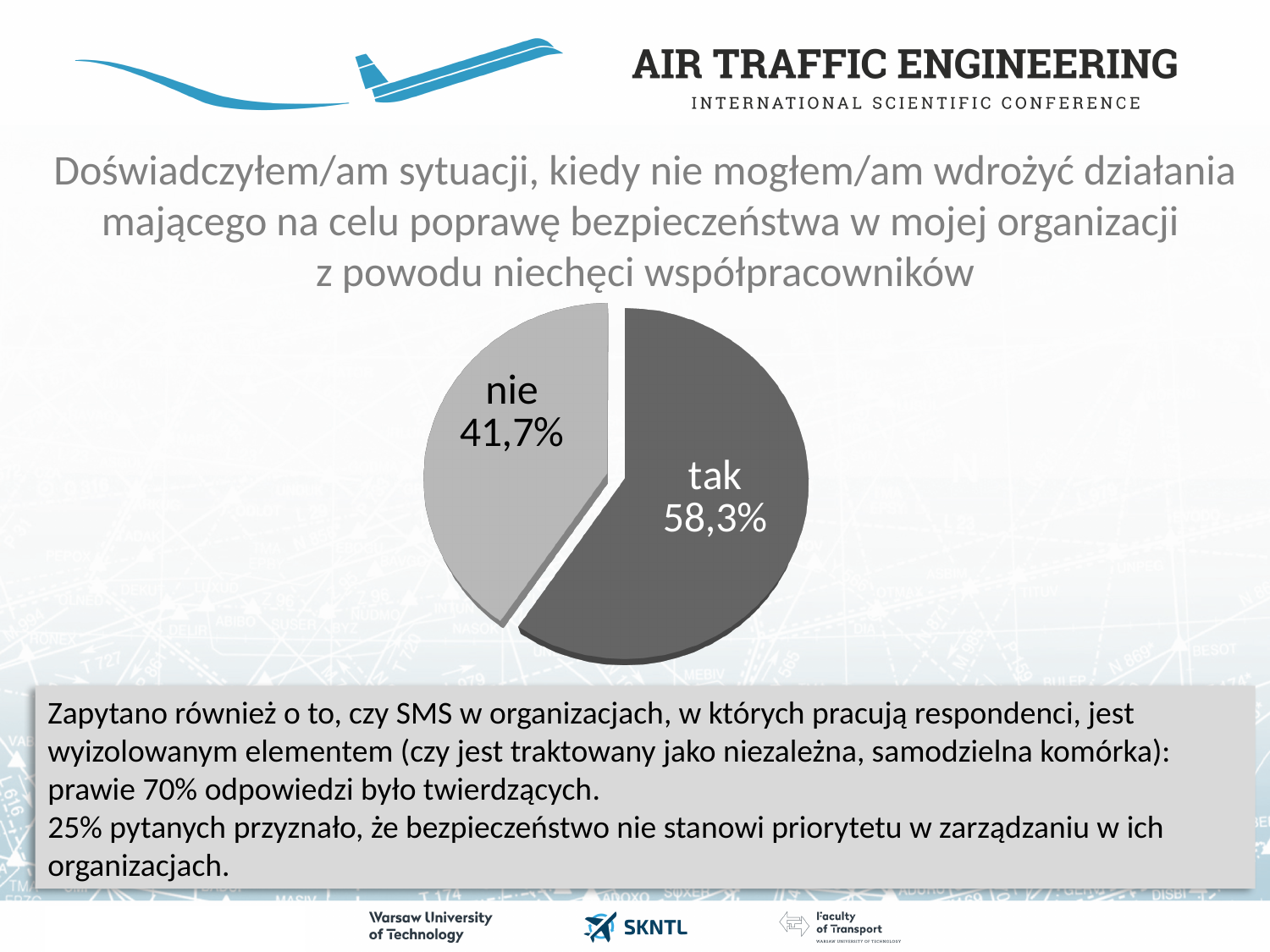
What is the difference in percentage points between the "tak" and "nie" slices? 16,6 What share of the pie does the "nie" slice represent? 41,7% Which slice of the pie is the smallest? nie Which is larger, the "tak" slice or the "nie" slice? tak Is the value for "tak" greater or less than 50%? greater Is the value for "nie" greater or less than 50%? less Which slice of the pie is shown in the darker grey colour? tak Which slice of the pie is the largest? tak What kind of chart is shown on the slide? pie chart What share of the pie does the "tak" slice represent? 58,3% How many slices does the pie chart have? 2